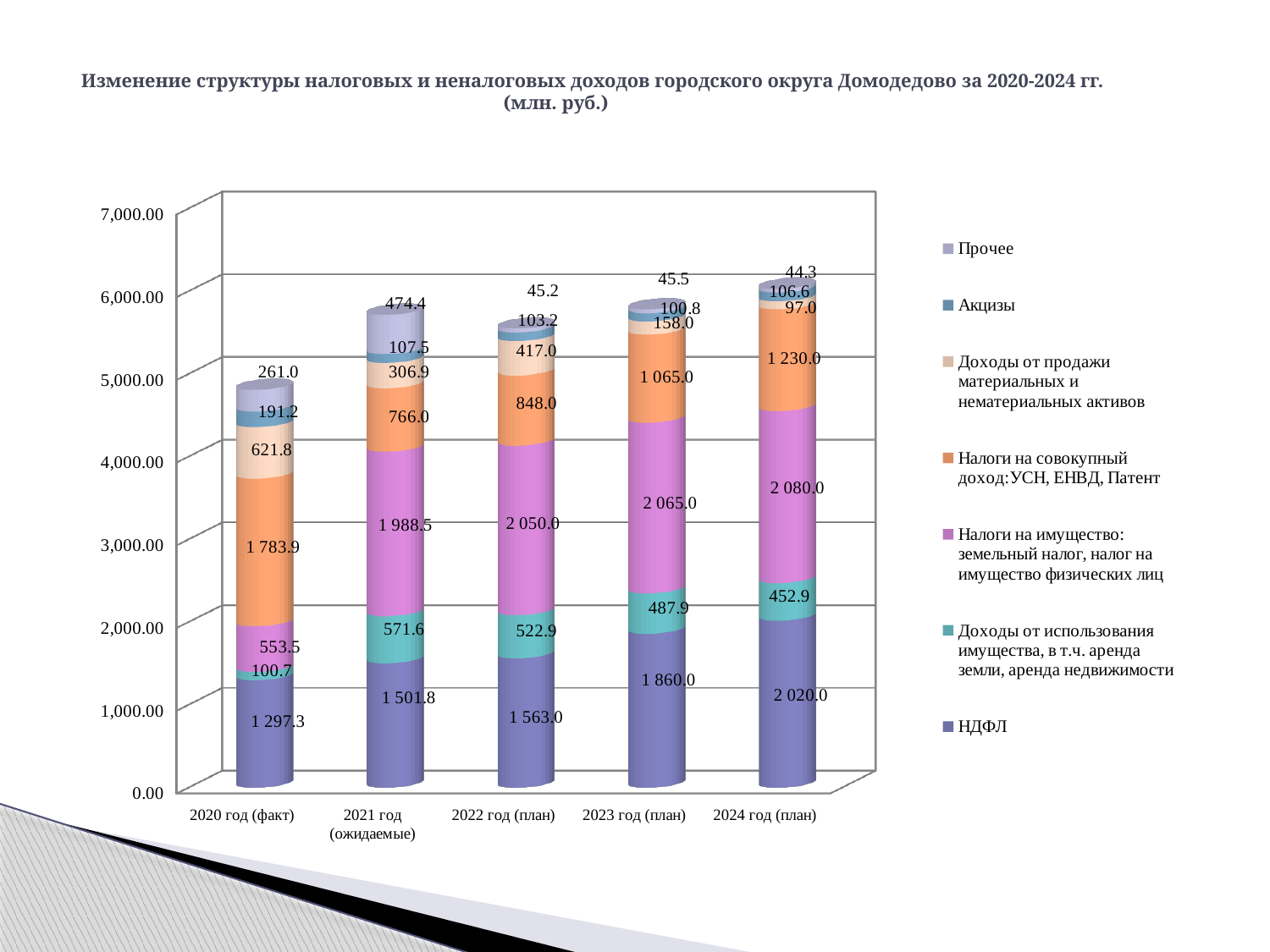
What is the value of Налоги на совокупный доход: УСН, ЕНВД, Патент for 2023 год (план)? 1 065.0 Does the НДФЛ value rise or fall from 2020 год (факт) to 2024 год (план)? rise In which year is the НДФЛ value the highest? 2024 год (план) What is the total of the stacked bar for 2020 год (факт)? 4 809.4 How many year categories are shown on the x axis? 5 What is the value of НДФЛ for 2020 год (факт)? 1 297.3 What type of chart is shown on the slide? stacked bar chart In which year is the Доходы от продажи материальных и нематериальных активов value the lowest? 2024 год (план) What is the difference between the НДФЛ values for 2024 год (план) and 2020 год (факт)? 722.7 How many series does the legend list? 7 What is the value of Прочее for 2021 год (ожидаемые)? 474.4 Which is larger: Налоги на имущество for 2022 год (план) or for 2021 год (ожидаемые)? 2022 год (план)